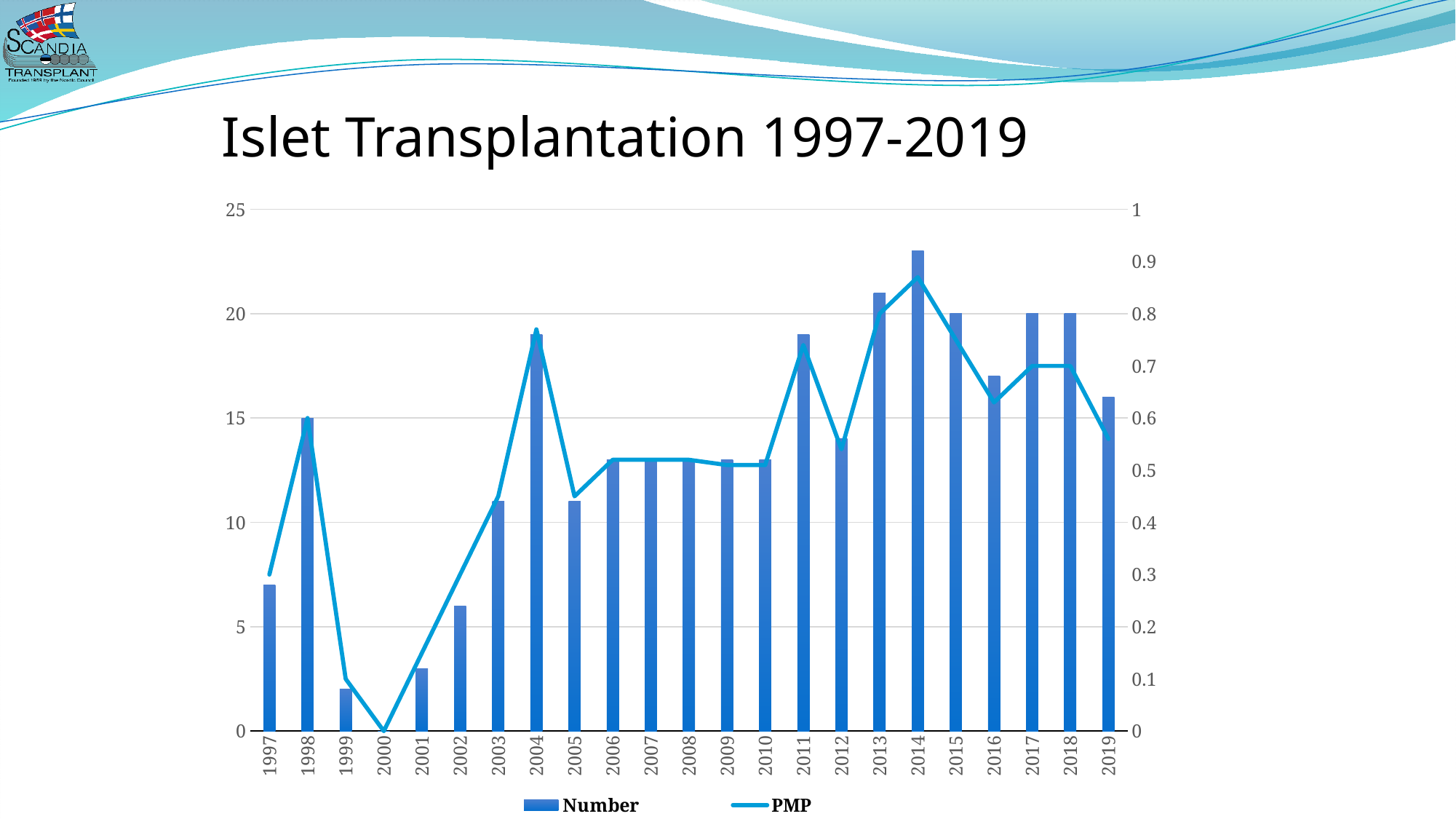
Which year has the highest Number? 2014 Is the Number for 2014 greater or less than 20? greater Which year has the larger Number, 2004 or 2005? 2004 Which year has the lowest Number? 2000 What kind of chart is shown on the slide? A bar chart combined with a line How many series does the legend list? 2 What is the Number for 2015? 20 Does the PMP line rise or fall from 2000 to 2004? rise Is the Number for 1997 greater or less than 5? greater How many years are shown on the x axis? 23 What are the two entries in the legend? Number and PMP What is the Number for 1998? 15